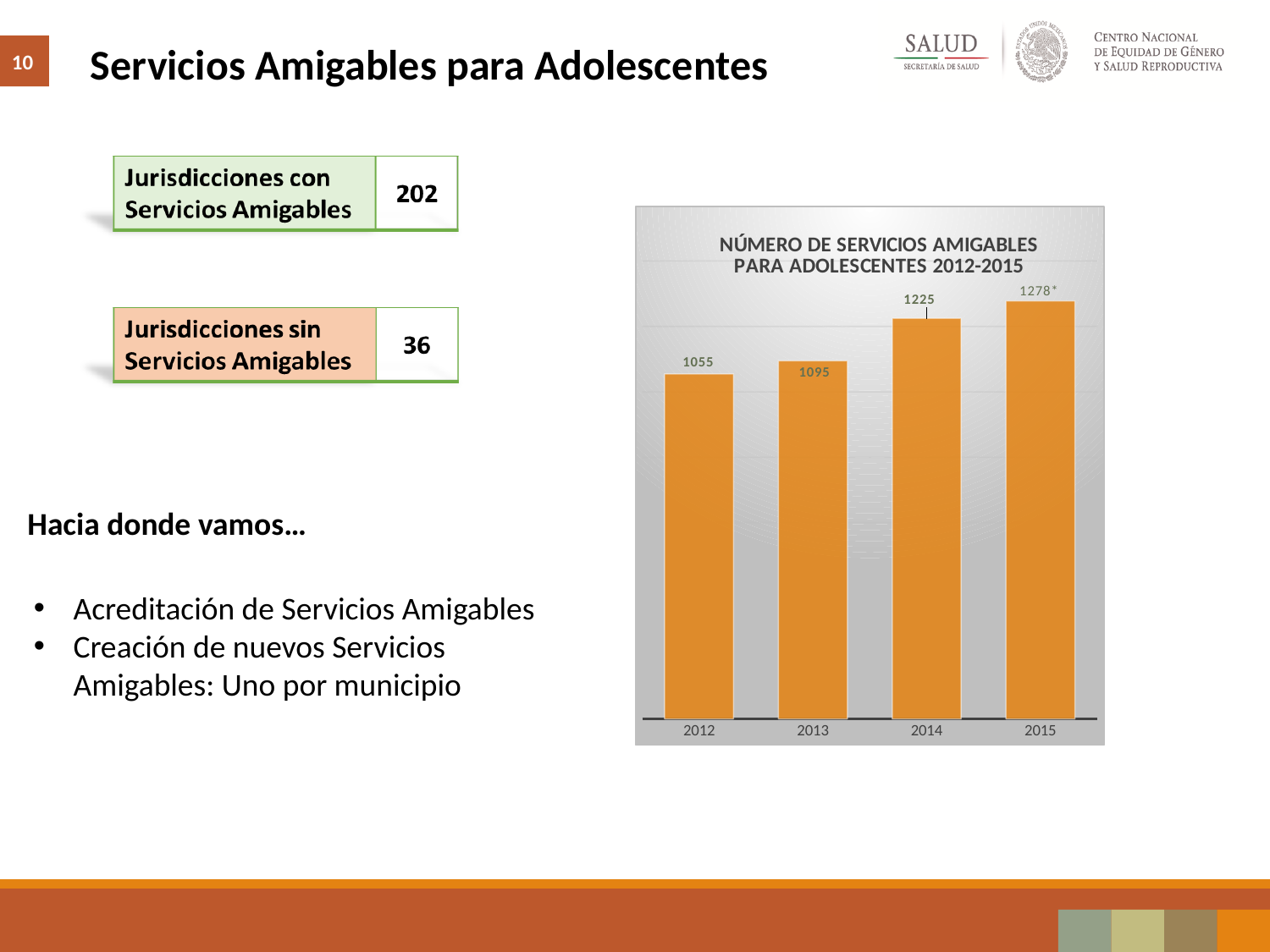
Do the values rise or fall from 2012 to 2015? rise Which is larger, the value for 2014 or the value for 2012? 2014 What is the difference between the values for 2013 and 2012? 40 What is the value for 2012 in the chart? 1055 What is the difference between the values for 2014 and 2013? 130 What is the data label shown for 2015 in the chart? 1278* Which year has the lowest value in the chart? 2012 What is the value for 2013 in the chart? 1095 What kind of chart is shown on the slide? bar chart What is the value for 2014 in the chart? 1225 How many years are shown on the x axis of the chart? 4 Which year has the highest value in the chart? 2015